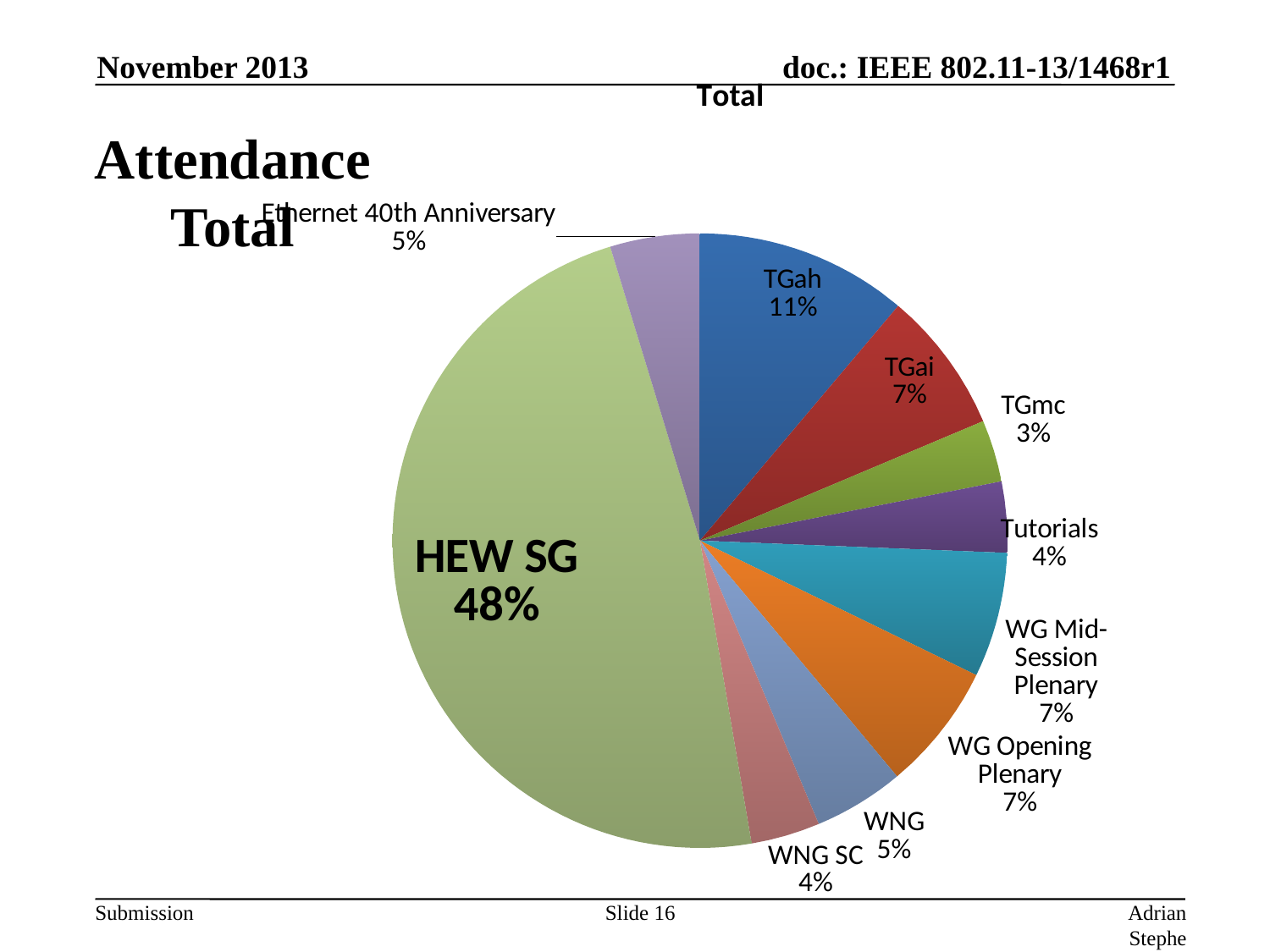
Which is larger, the share for TGah or the share for TGai? TGah What share of the pie does TGah have? 11% What share of the pie does Ethernet 40th Anniversary have? 5% What share of the pie does TGmc have? 3% Which slice is the smallest? TGmc What kind of chart is shown on the slide? pie chart What is the difference in percentage points between the HEW SG share and the TGah share? 37 Which slice is the largest? HEW SG How many slices does the pie chart have? 10 What is the chart's title? Total